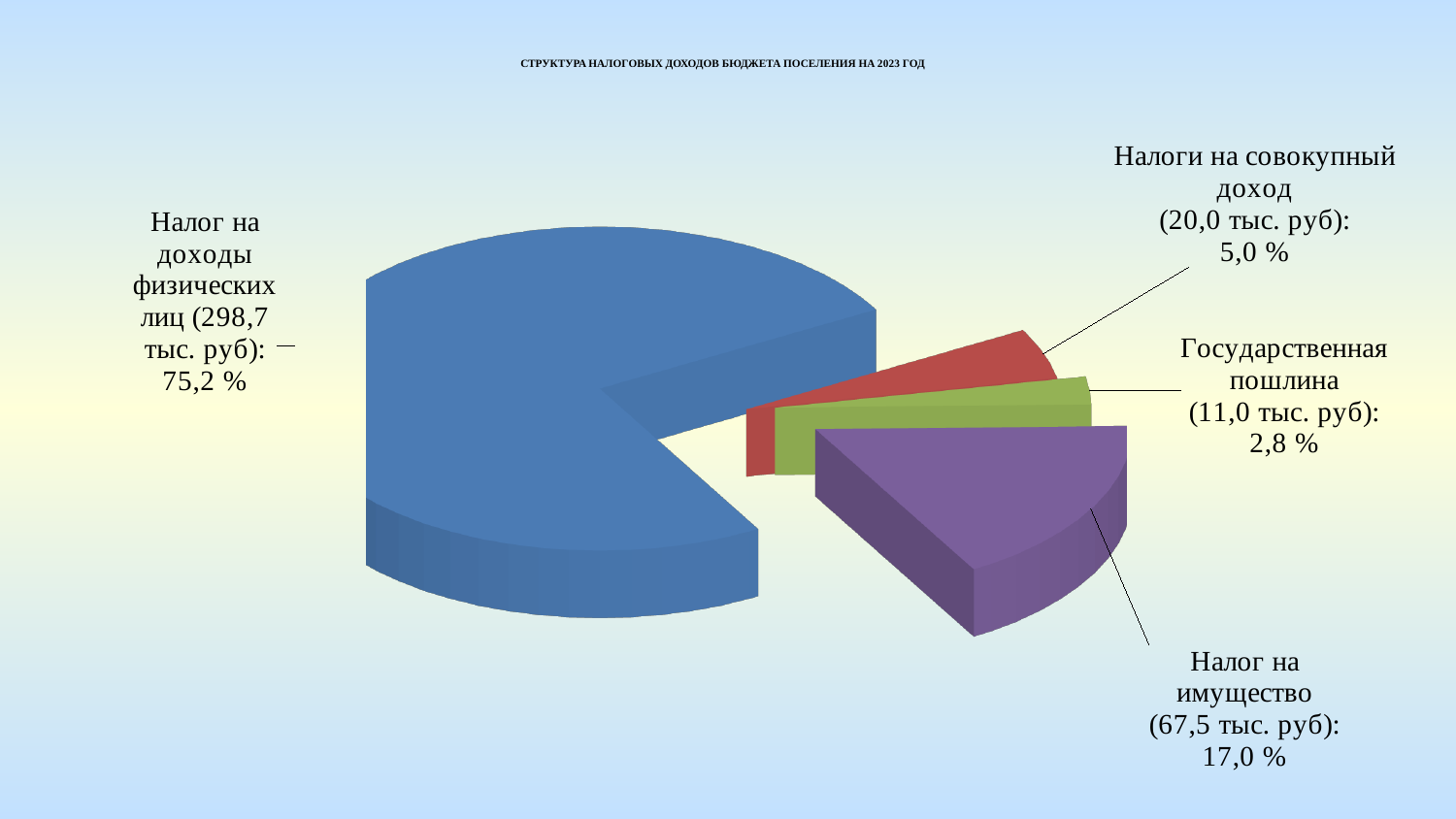
What is the difference in тыс. руб between "Налог на имущество" and "Налоги на совокупный доход"? 47,5 тыс. руб How many slices does the pie chart have? 4 What amount in тыс. руб is shown for "Налог на имущество"? 67,5 тыс. руб What share of the pie does "Государственная пошлина" represent? 2,8 % Which category has the largest slice of the pie? Налог на доходы физических лиц What is the title of the chart? СТРУКТУРА НАЛОГОВЫХ ДОХОДОВ БЮДЖЕТА ПОСЕЛЕНИЯ НА 2023 ГОД What share of the pie does "Налог на имущество" represent? 17,0 % Which is larger: "Налоги на совокупный доход" or "Государственная пошлина"? Налоги на совокупный доход What share of the pie does "Налог на доходы физических лиц" represent? 75,2 % What amount in тыс. руб is shown for "Налоги на совокупный доход"? 20,0 тыс. руб What kind of chart is shown on the slide? pie chart Which category has the smallest slice of the pie? Государственная пошлина